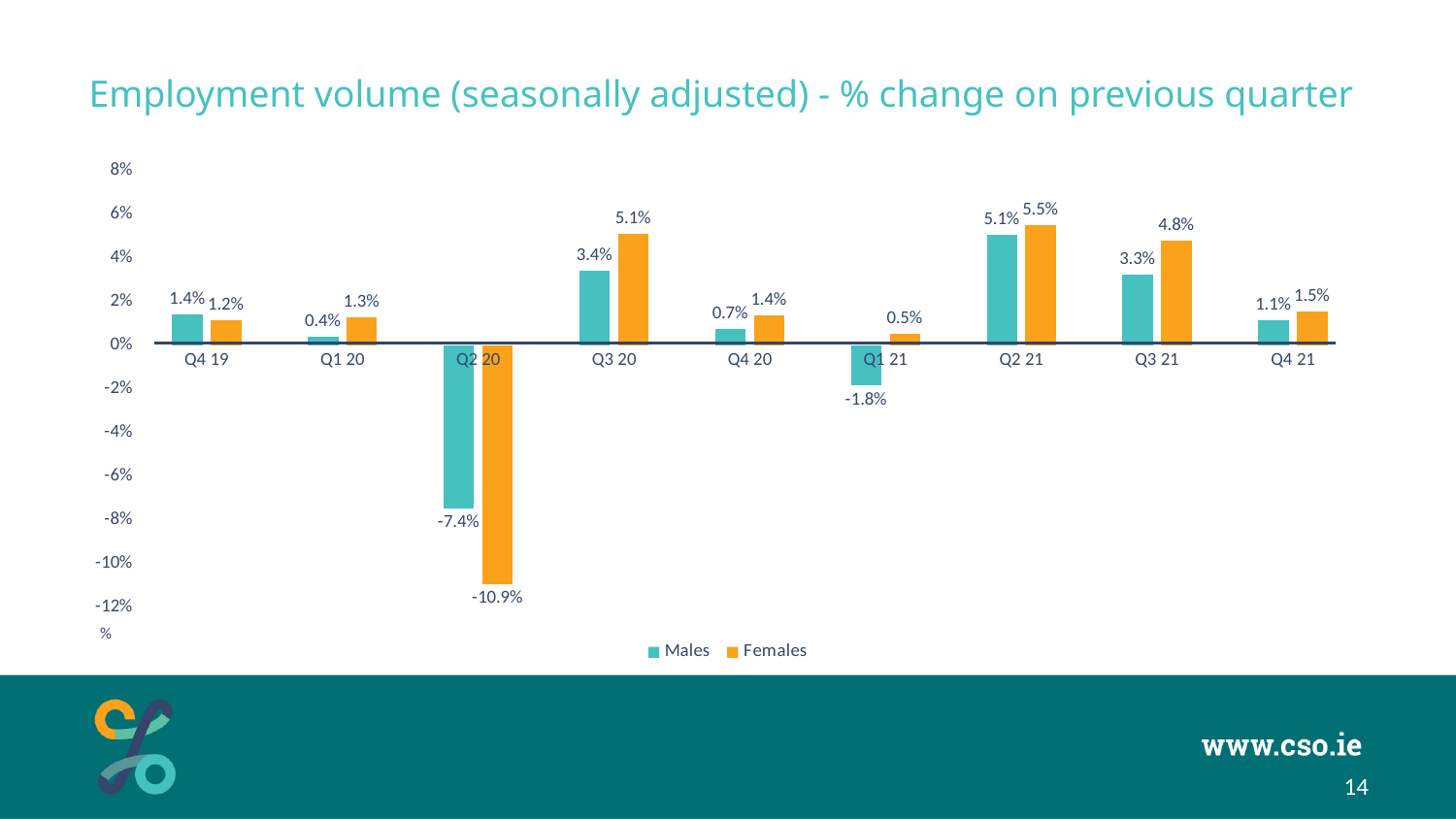
Which is larger in Q4 19, the Males value or the Females value? Males In which quarter is the Females value highest? Q2 21 How many quarters are shown on the x axis? 9 What is the difference between the Females and Males values in Q2 20? 3.5 percentage points How many series does the legend list? 2 What is the value for Females in Q3 21? 4.8% In which quarter is the Females value lowest? Q2 20 What colour represents the Females series? Orange What is the value for Males in Q1 21? -1.8% What kind of chart is shown? Bar chart What is the difference between the Males values in Q2 21 and Q3 21? 1.8 percentage points What is the value for Males in Q2 20? -7.4%